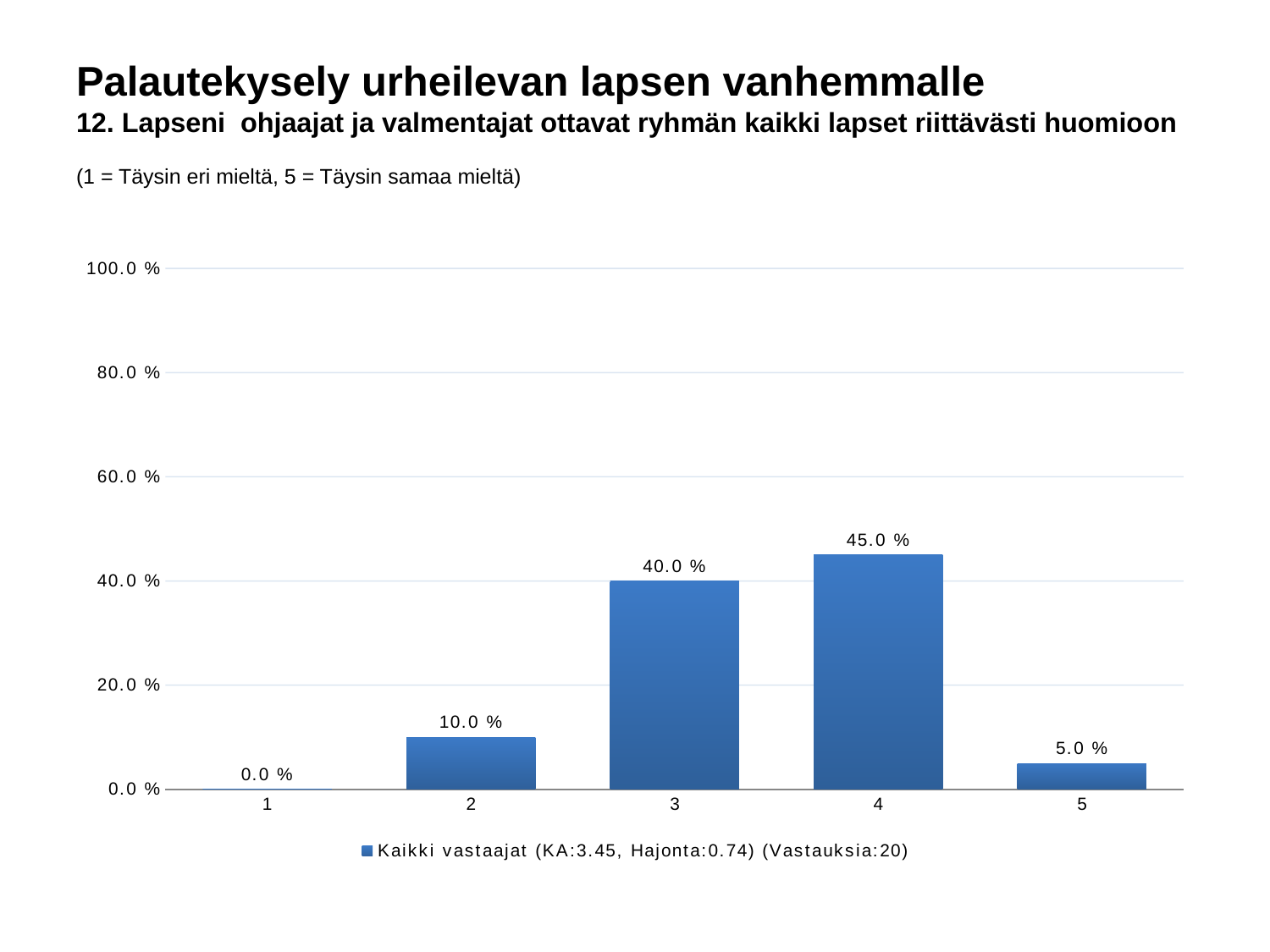
What is the legend entry for the series? Kaikki vastaajat (KA:3.45, Hajonta:0.74) (Vastauksia:20) How many categories are shown on the x axis? 5 What is the difference between the values for categories 4 and 3? 5.0 % What kind of chart is shown on the slide? bar chart What is the value for category 2? 10.0 % Which is larger, the value for category 3 or the value for category 5? 3 Is the value for category 3 greater or less than 20.0 %? greater Which category has the lowest value? 1 Which category has the highest value? 4 What is the value for category 1? 0.0 % How many series does the legend list? 1 What is the value for category 4? 45.0 %